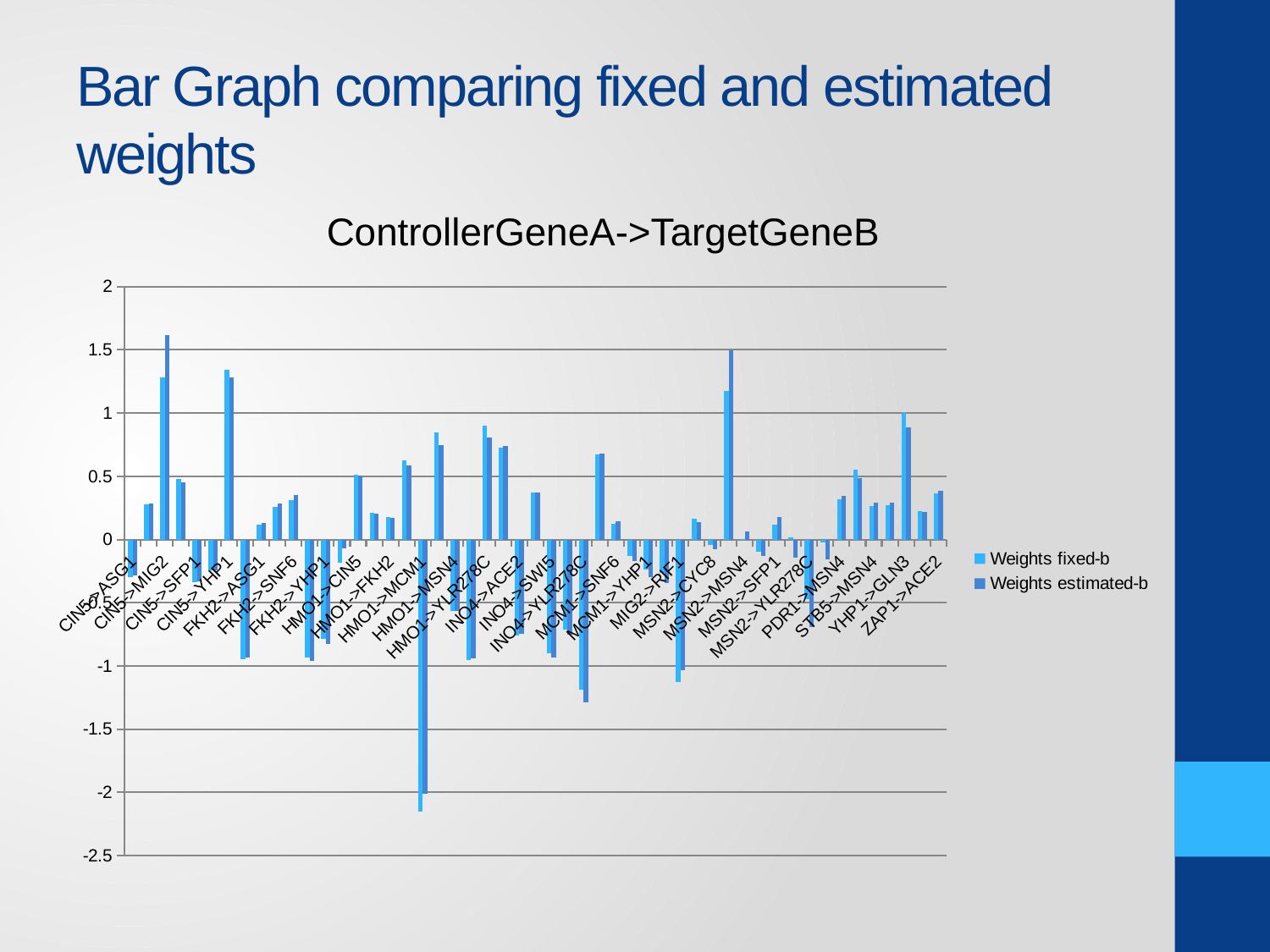
What kind of chart is shown on the slide? bar chart What is the title of the chart? ControllerGeneA->TargetGeneB Is the highest value plotted for Weights fixed-b greater or less than 1? greater Is the lowest value plotted for Weights fixed-b greater or less than -2? less Does any bar on the chart reach the value 2 on the y axis? No Which series contains the lowest bar on the chart? Weights fixed-b What are the two series named in the legend? Weights fixed-b and Weights estimated-b How many series does the chart legend list? 2